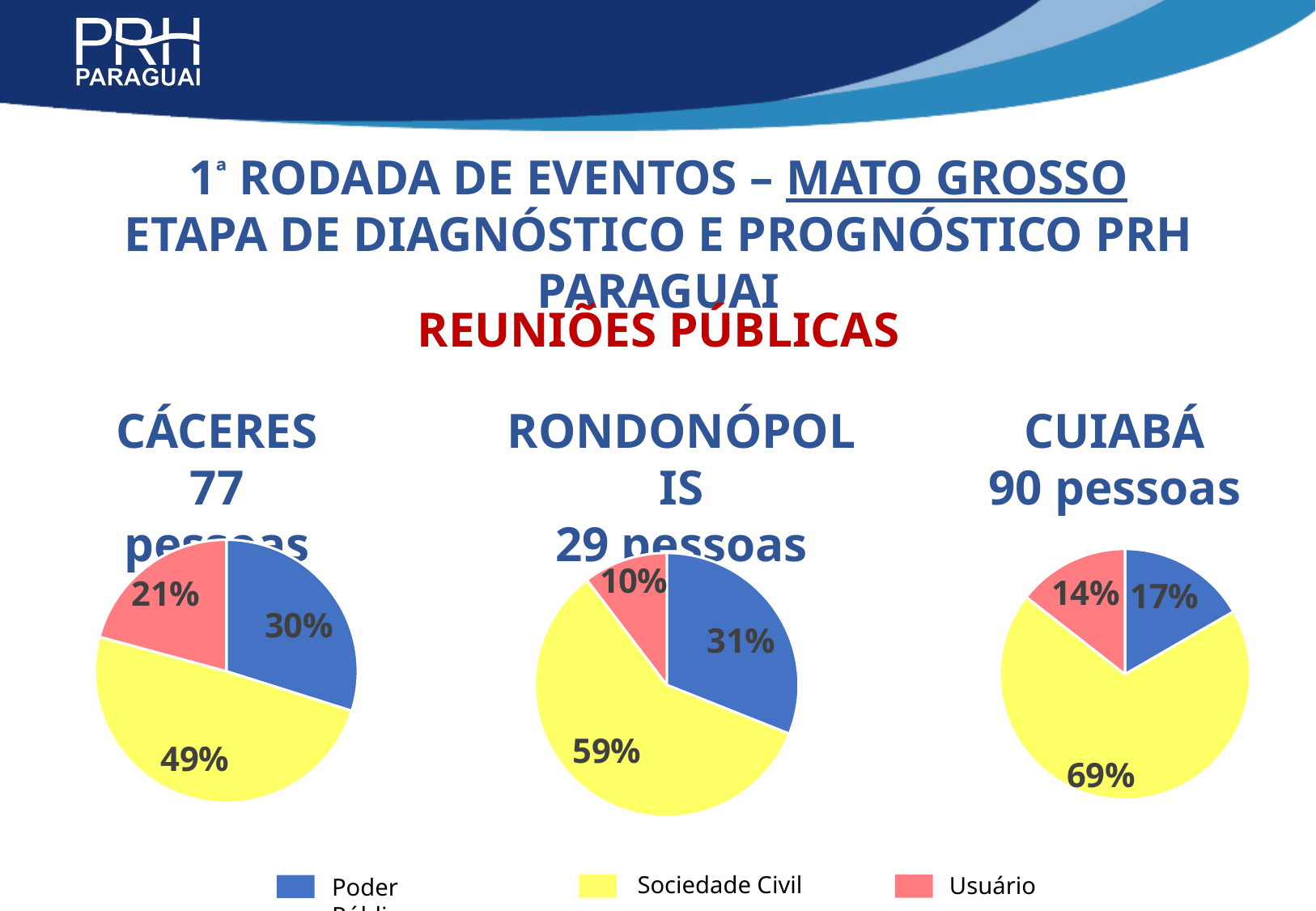
What kind of chart is used for the Cáceres data? pie chart In the Rondonópolis pie chart, what share is Usuário? 10% In the Rondonópolis pie chart, which category has the largest slice? Sociedade Civil In the Cuiabá pie chart, which category has the smallest slice? Usuário In the Cáceres pie chart, what is the difference between the Sociedade Civil share and the Poder Público share? 19% How many slices does each pie chart have? 3 In the Cuiabá pie chart, what share is Sociedade Civil? 69% In the Cáceres pie chart, what share is Sociedade Civil? 49% Which colour represents Sociedade Civil in the legend? yellow Which is larger in the Cuiabá pie chart: Poder Público or Usuário? Poder Público